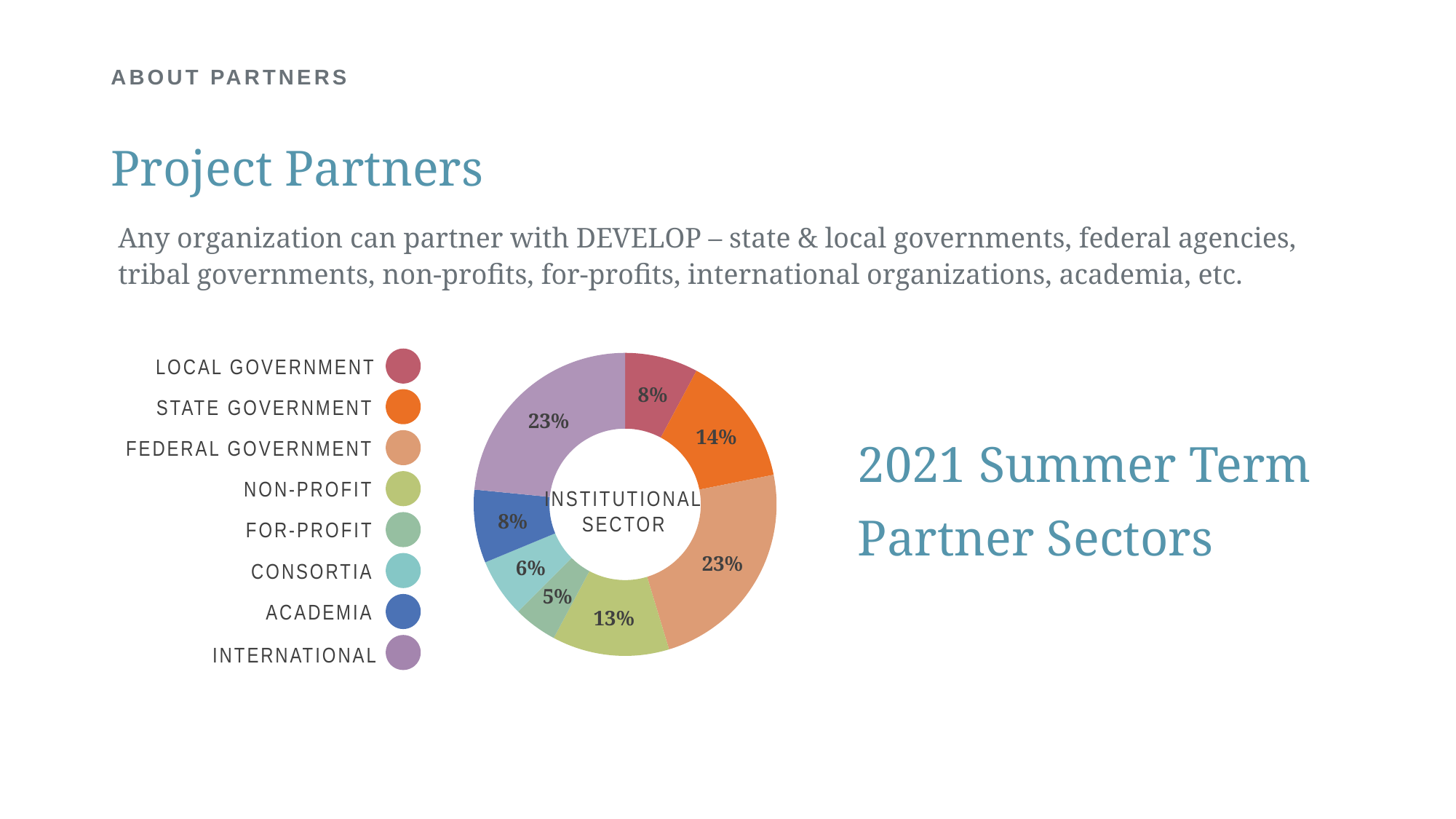
What is the value shown for Non-Profit in the pie chart? 13% What percentage is labelled on the Consortia slice? 6% What percentage does the State Government slice show? 14% What is the combined share of the Local Government and Academia slices? 16% Which sector has the smallest slice in the pie chart? For-Profit What type of chart is shown on the slide? Doughnut chart Which slice is larger, State Government or Non-Profit? State Government What share of the pie chart is Federal Government? 23% Which colour represents International in the legend? Purple What is the difference in percentage points between the International and Academia slices? 15 What text appears in the centre of the pie chart? Institutional Sector How many sectors are shown in the pie chart? 8